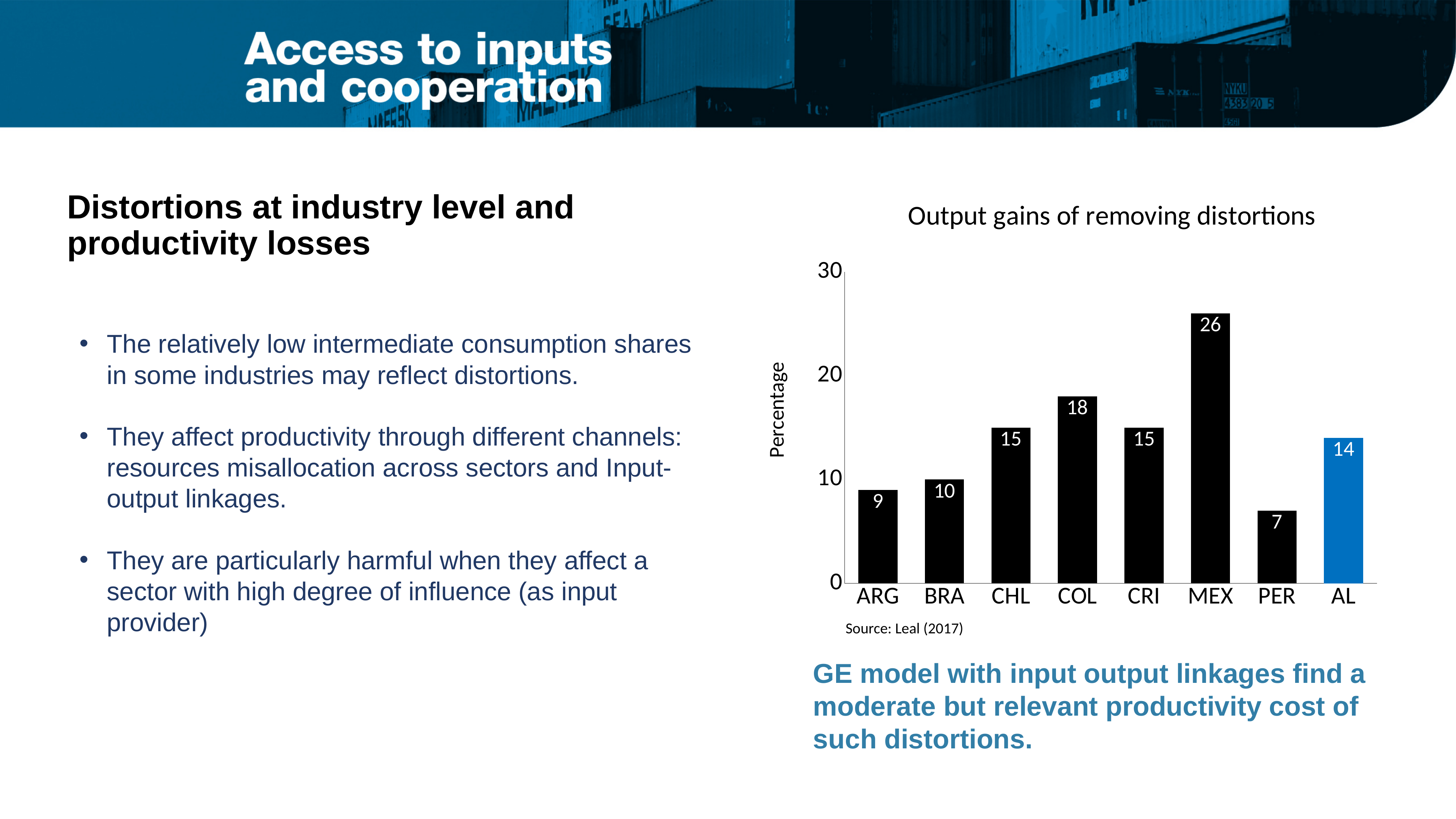
Which bar in the chart is coloured blue rather than black? AL Which has a larger value, BRA or CHL? CHL How many countries/categories are shown on the x axis of the chart? 8 What is the value for PER in the chart? 7 What is the difference between the values for MEX and COL? 8 Which country has the lowest output gain in the chart? PER Which country has the highest output gain in the chart? MEX What is the value for AL in the chart? 14 Is the value for COL greater or less than 20? less What kind of chart is shown on the slide? bar chart What is the value for MEX in the chart? 26 What is the title of the chart? Output gains of removing distortions